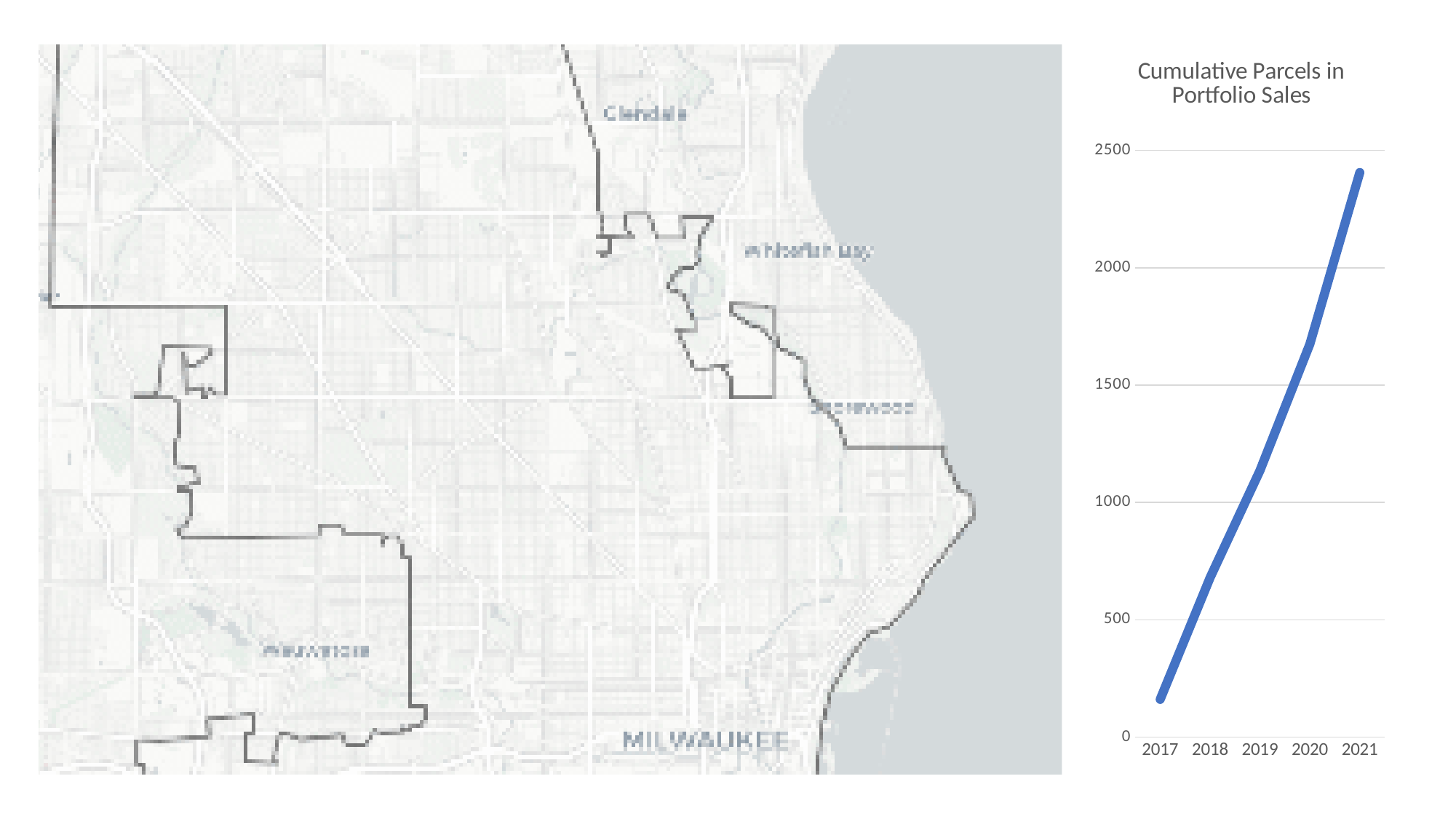
In the Cumulative Parcels in Portfolio Sales chart, which is larger, the value for 2018 or the value for 2020? 2020 What is the title of the chart on the right side of the slide? Cumulative Parcels in Portfolio Sales In the Cumulative Parcels in Portfolio Sales chart, is the value for 2020 greater or less than 1500? greater In the Cumulative Parcels in Portfolio Sales chart, is the value for 2021 greater or less than 2000? greater How many years are shown on the x axis of the Cumulative Parcels in Portfolio Sales chart? 5 In the Cumulative Parcels in Portfolio Sales chart, is the value for 2018 greater or less than 1000? less In the Cumulative Parcels in Portfolio Sales chart, which year has the highest value? 2021 What kind of chart is shown on the right side of the slide? line chart In the Cumulative Parcels in Portfolio Sales chart, which year has the lowest value? 2017 In the Cumulative Parcels in Portfolio Sales chart, do the values rise or fall from 2017 to 2021? rise